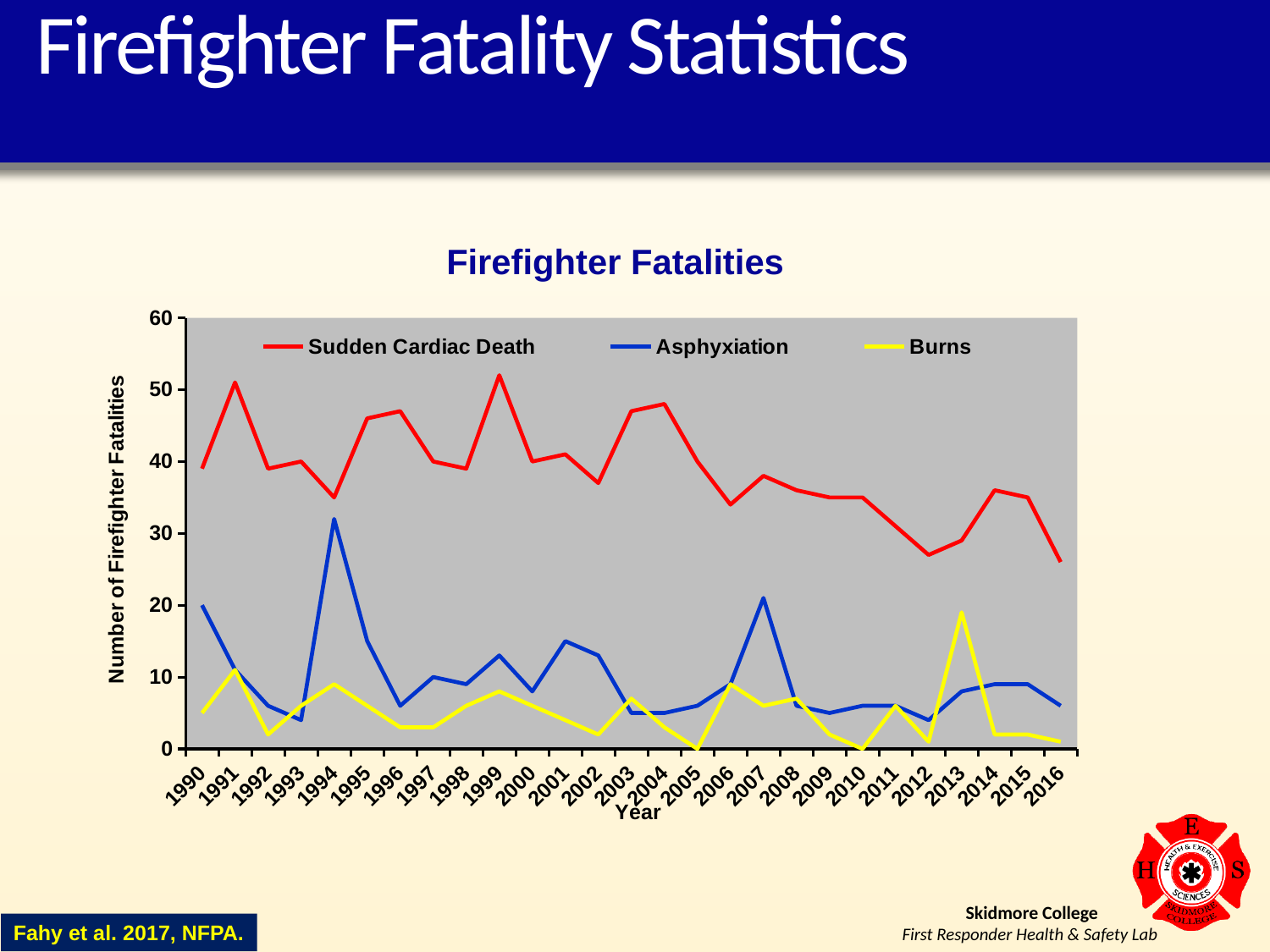
What is the title of the chart? Firefighter Fatalities What kind of chart is shown on the slide? line chart In 2007, which is larger, Asphyxiation or Burns? Asphyxiation Is the value for Asphyxiation in 1994 greater or less than 20? greater Overall, does the Sudden Cardiac Death series rise or fall from 1990 to 2016? fall In which year does the Asphyxiation series reach its highest value? 1994 How many years are plotted along the x axis? 27 Is the value for Sudden Cardiac Death in 2016 greater or less than 30? less In which year does the Burns series reach its highest value? 2013 What is the label of the y axis? Number of Firefighter Fatalities Which series has the highest values across all years? Sudden Cardiac Death How many series does the legend list? 3